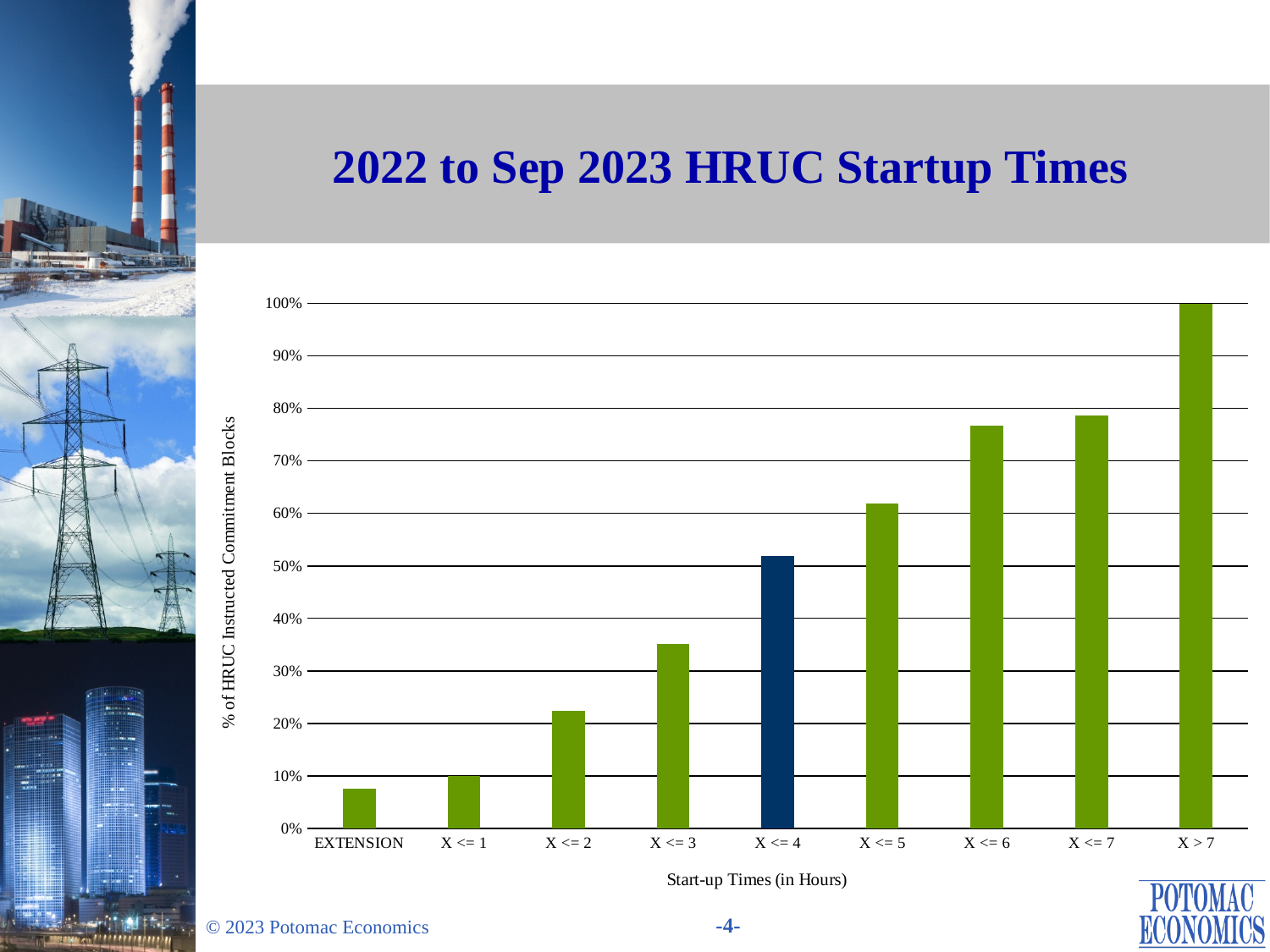
Which is larger, the value for X <= 5 or the value for X <= 3? X <= 5 Do the values rise or fall moving from left to right along the x axis? rise Is the value for X <= 6 greater or less than 80%? less Which category has the lowest value in the chart? EXTENSION Is the value for X <= 3 greater or less than 30%? greater Is the value for X <= 4 greater or less than 60%? less Which category has the highest value in the chart? X > 7 What is the value for X > 7? 100% What is the title of the x axis of the chart? Start-up Times (in Hours) What kind of chart is shown on the slide? bar chart How many categories are shown on the x axis of the chart? 9